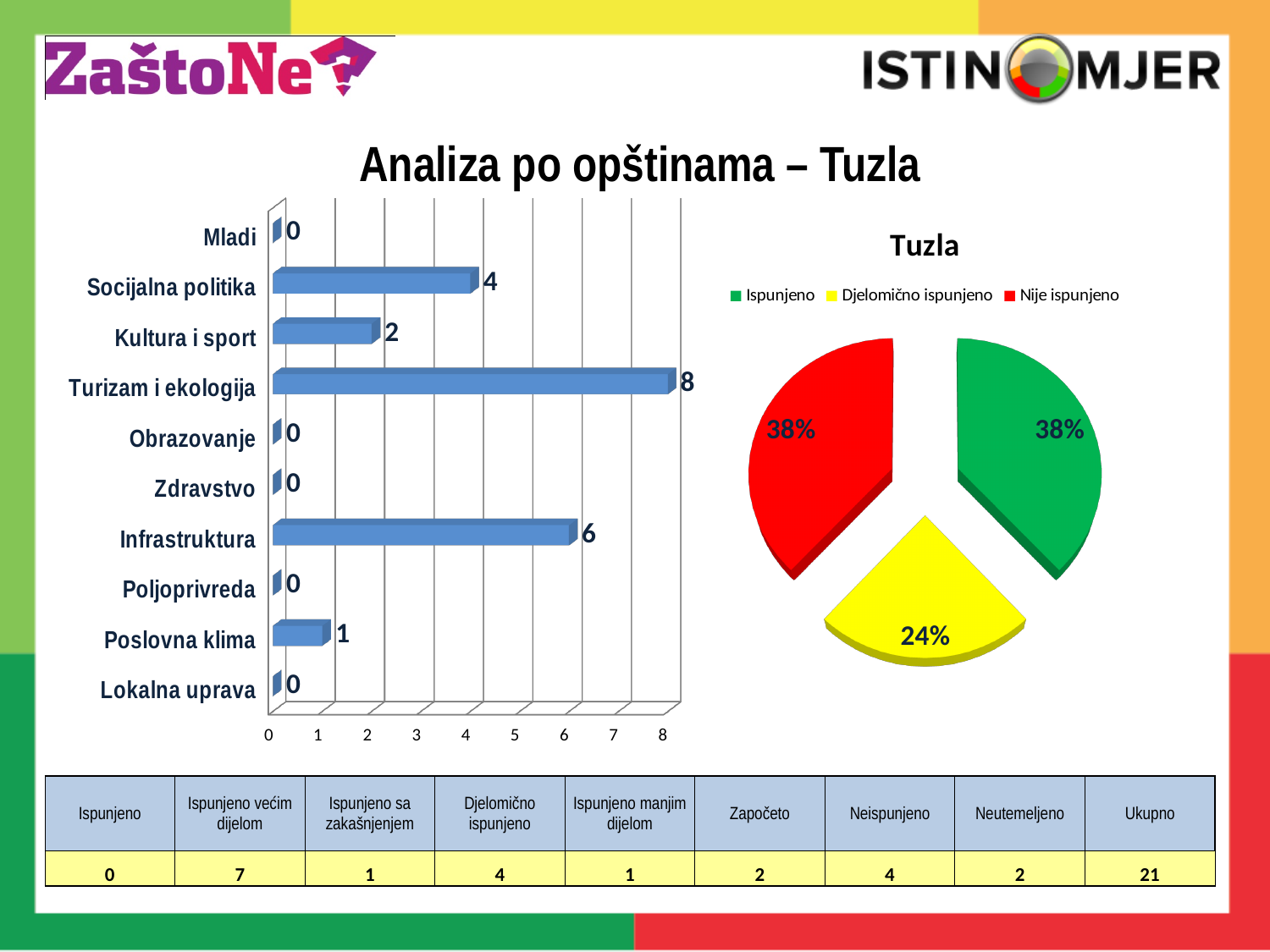
In the bar chart on the left, which category has the highest value? Turizam i ekologija What kind of chart is the chart on the left of the slide? Bar chart In the pie chart titled Tuzla, which colour represents Nije ispunjeno? Red In the pie chart titled Tuzla, what share does Djelomično ispunjeno have? 24% In the bar chart on the left, what is the value for Infrastruktura? 6 In the bar chart on the left, which is larger, the value for Infrastruktura or the value for Kultura i sport? Infrastruktura In the bar chart on the left, how many categories are shown? 10 In the bar chart on the left, what is the difference between the values for Turizam i ekologija and Socijalna politika? 4 In the bar chart on the left, what is the value for Turizam i ekologija? 8 In the pie chart titled Tuzla, how many entries does the legend list? 3 In the bar chart on the left, what is the value for Poslovna klima? 1 In the bar chart on the left, how many categories have a value of 0? 5